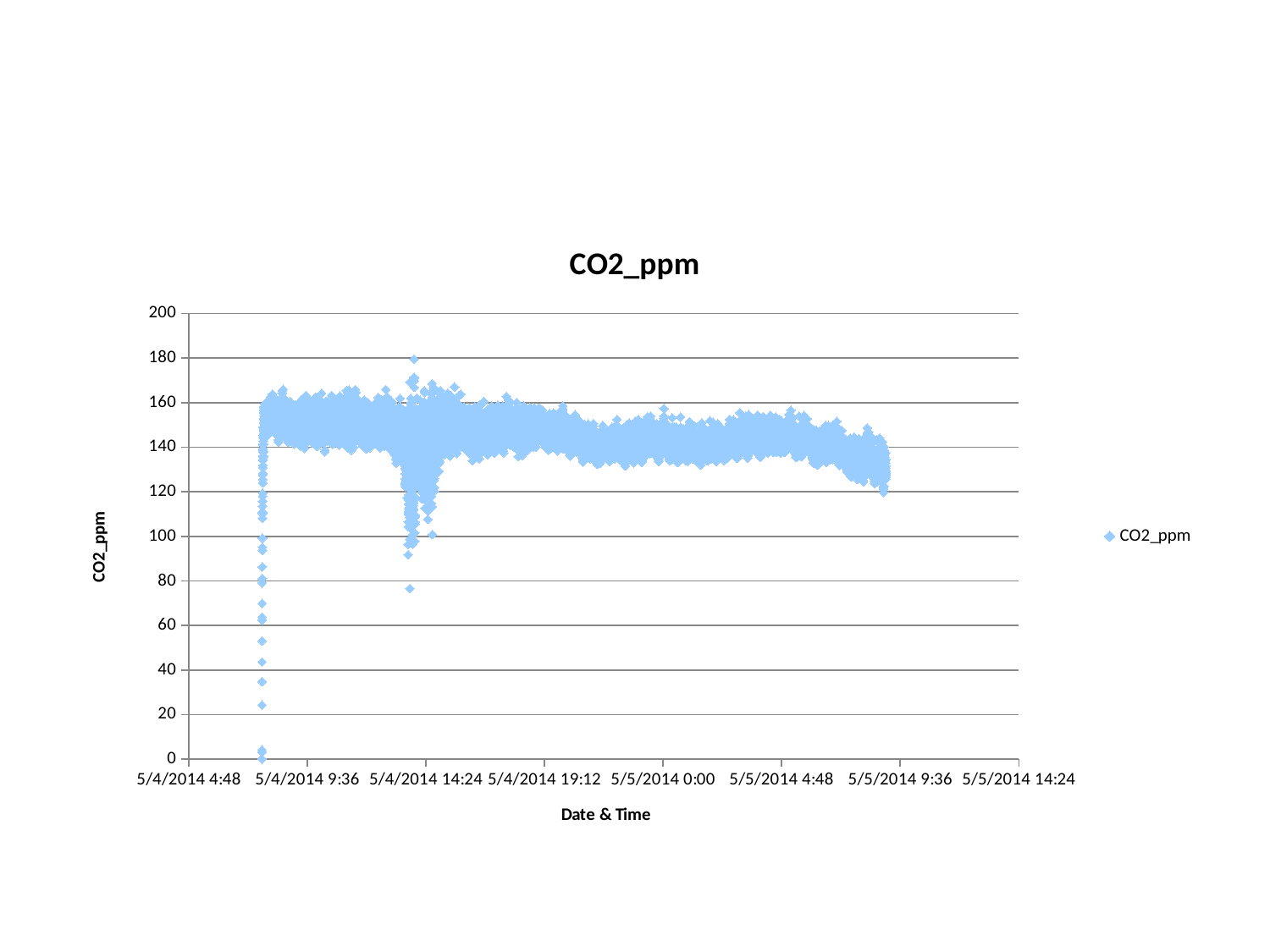
Are the CO2_ppm values around 5/5/2014 0:00 greater or less than 160? less Are the bulk of the CO2_ppm values around 5/4/2014 9:36 greater or less than 120? greater What kind of chart is shown on the slide? scatter chart Do the typical CO2_ppm values rise or fall from 5/4/2014 9:36 to 5/5/2014 4:48? fall Are the CO2_ppm values around 5/5/2014 0:00 greater or less than 120? greater What is the title of the chart? CO2_ppm What is the label of the x axis? Date & Time How many series does the legend list? 1 What is the highest value shown on the y axis? 200